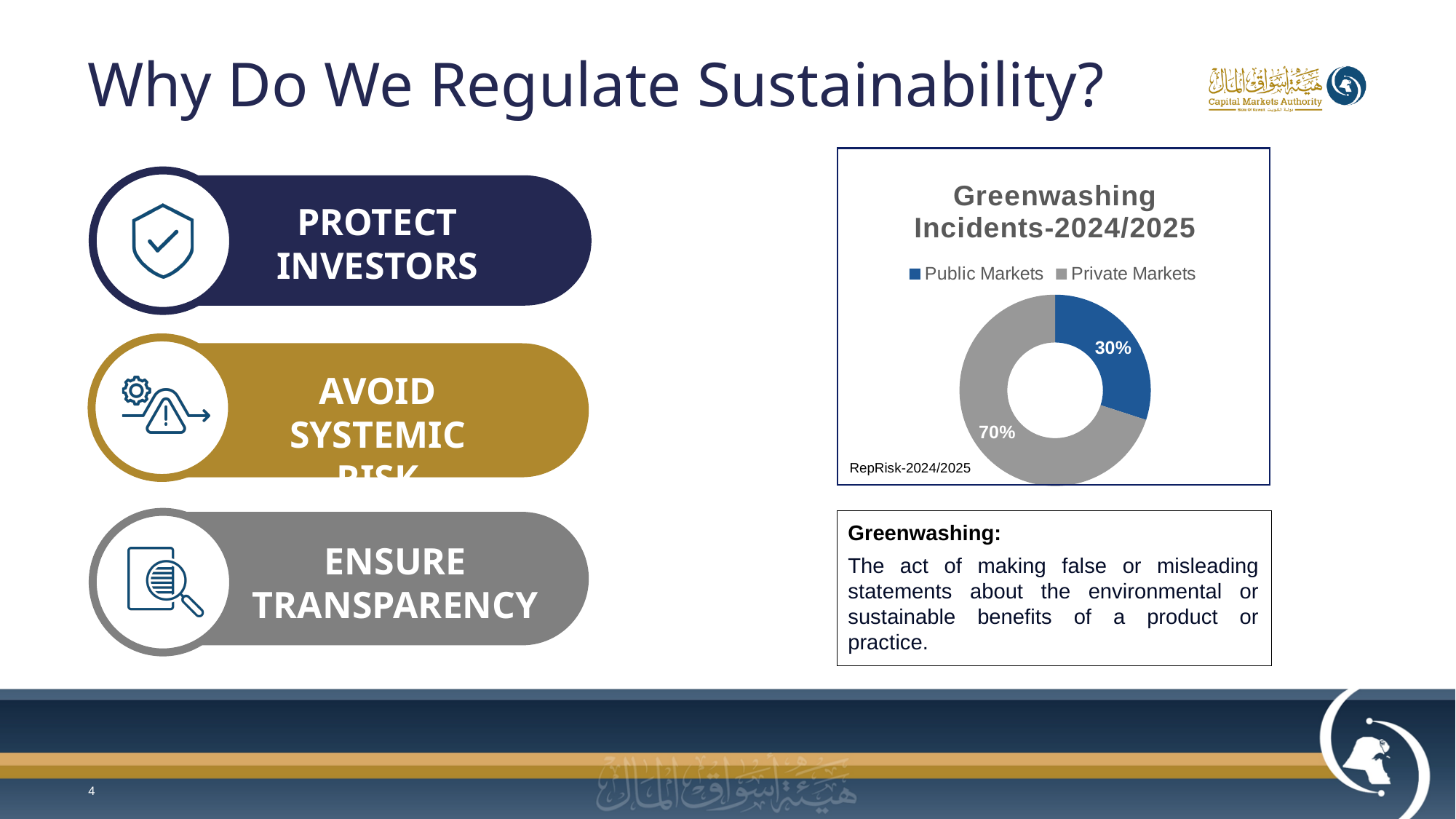
What colour represents Private Markets in the chart? Grey What kind of chart is shown on the slide? Pie chart (doughnut) What share of greenwashing incidents is attributed to Private Markets? 70% How many entries does the chart legend list? 2 What is the title of the chart? Greenwashing Incidents-2024/2025 Which is larger: the share for Public Markets or for Private Markets? Private Markets What share of greenwashing incidents is attributed to Public Markets? 30% How many categories does the chart show? 2 Which category has the smallest share of greenwashing incidents? Public Markets Which category has the largest share of greenwashing incidents? Private Markets What is the difference in percentage points between the Private Markets and Public Markets shares? 40